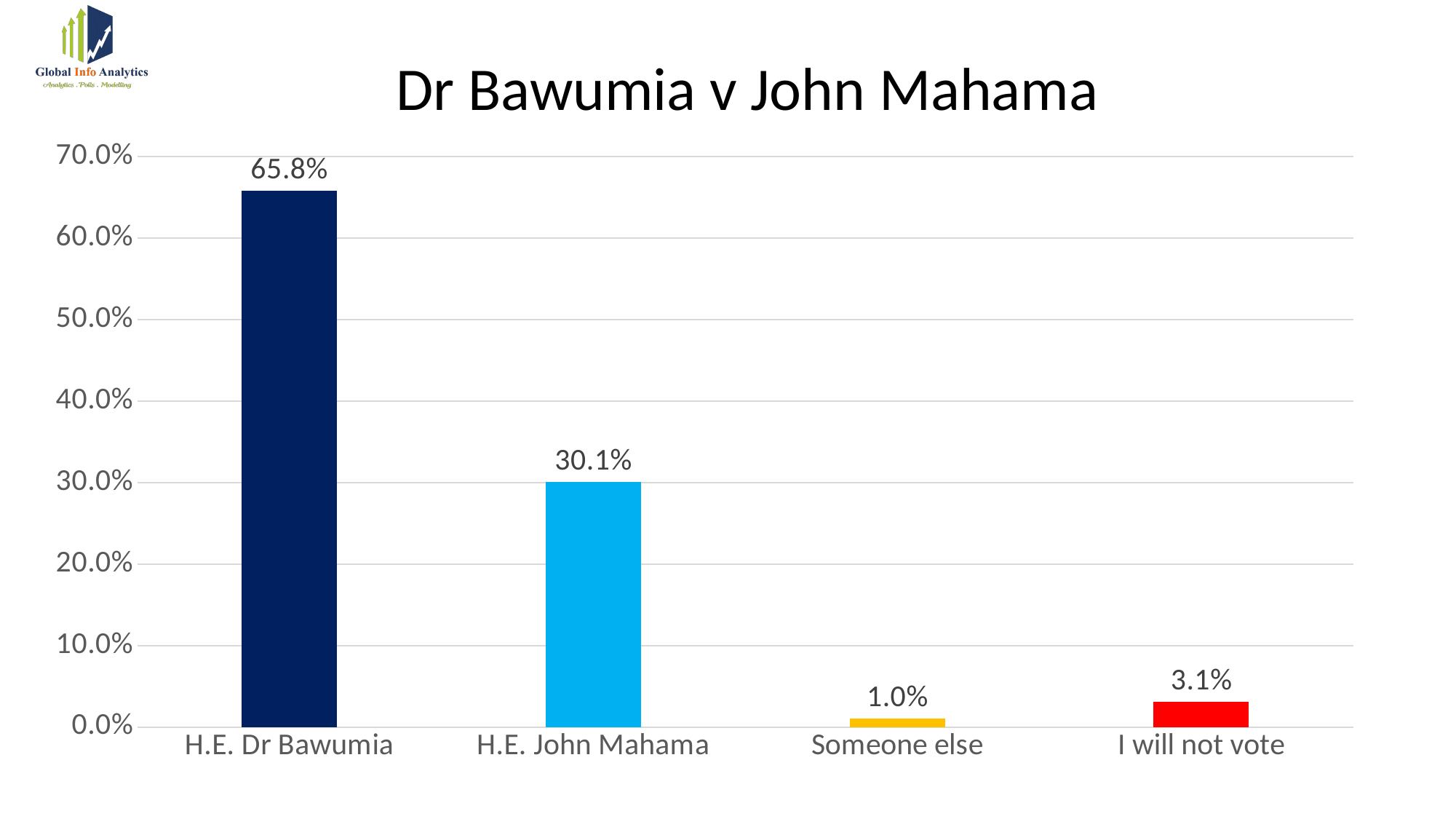
What kind of chart is shown on the slide? Bar chart What is the difference between the values for H.E. Dr Bawumia and H.E. John Mahama? 35.7% What is the value for I will not vote? 3.1% Which category has the highest value? H.E. Dr Bawumia What is the value for Someone else? 1.0% Is the value for H.E. John Mahama greater or less than 40.0%? less What is the value for H.E. Dr Bawumia? 65.8% Which category has the lowest value? Someone else What is the title of the chart? Dr Bawumia v John Mahama What is the value for H.E. John Mahama? 30.1% Which is larger, the value for I will not vote or the value for Someone else? I will not vote How many categories are shown on the chart? 4